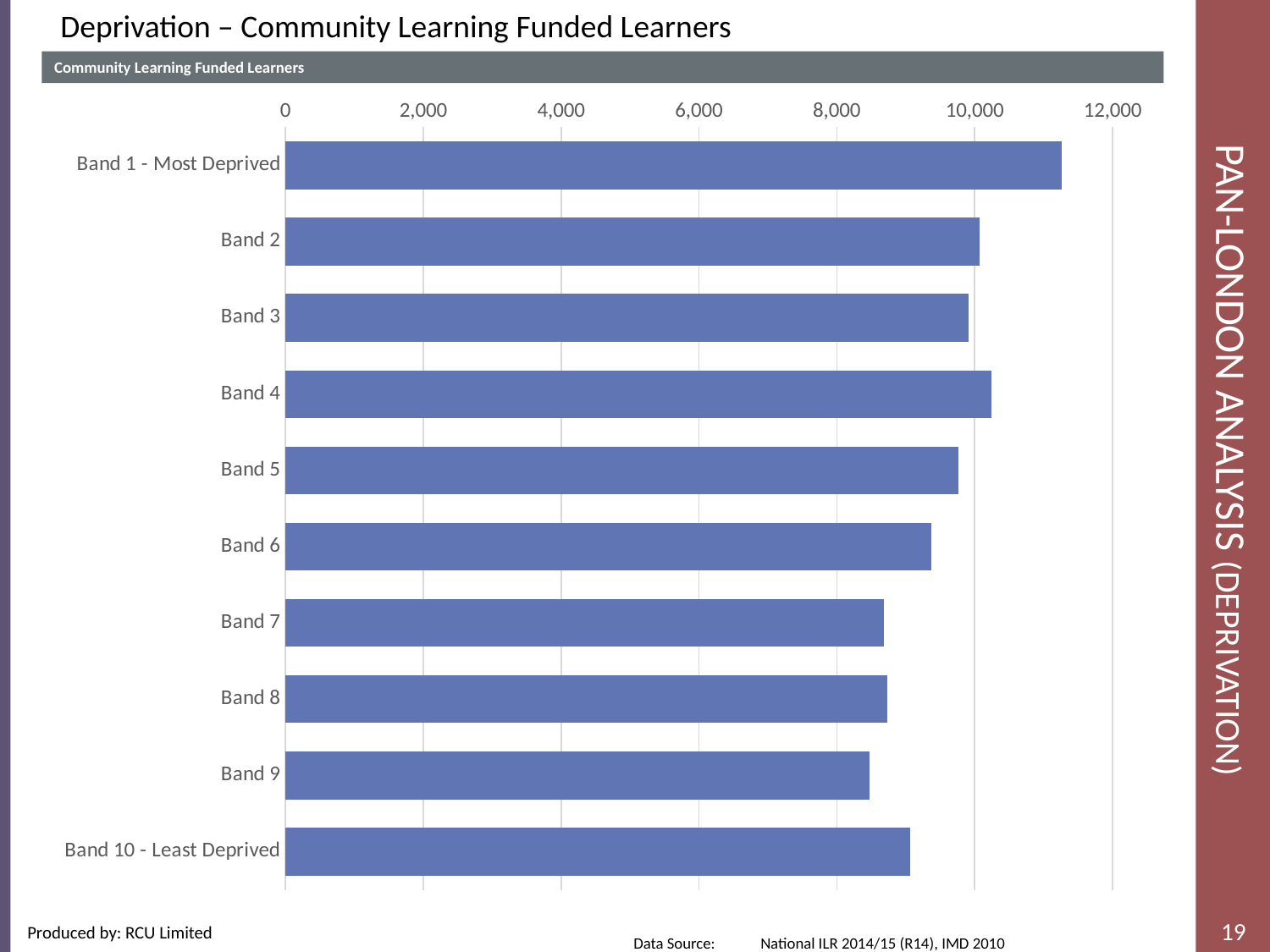
Which band has the highest number of Community Learning funded learners? Band 1 - Most Deprived Is the value for Band 9 greater or less than 10,000? less What is the highest value shown on the horizontal axis of the chart? 12,000 How many deprivation bands are plotted in the chart? 10 What type of chart is shown on the slide? bar chart Which has more learners, Band 1 - Most Deprived or Band 10 - Least Deprived? Band 1 - Most Deprived Do the values generally rise or fall from Band 1 to Band 10? fall Is the value for Band 6 greater or less than 10,000? less Is the value for Band 10 - Least Deprived greater or less than 8,000? greater Which has more learners, Band 4 or Band 6? Band 4